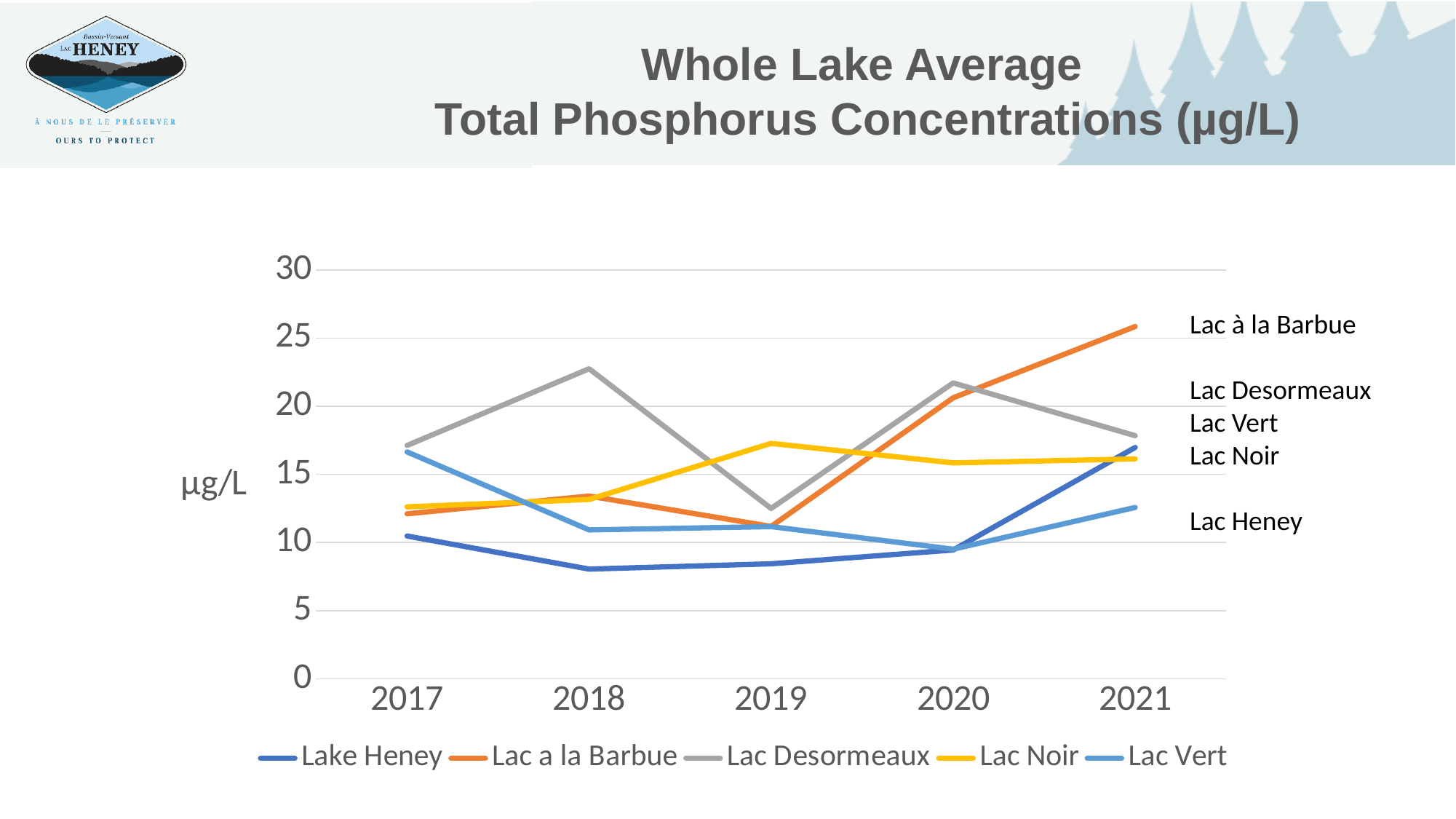
Which lake has the lowest total phosphorus concentration in 2018? Lake Heney What kind of chart is shown on the slide? line chart Is the value for Lac a la Barbue in 2021 greater or less than 25? greater How many years are shown on the x axis? 5 Which lake has the highest total phosphorus concentration in 2018? Lac Desormeaux Is the value for Lac Desormeaux in 2018 greater or less than 20? greater Does the value for Lac a la Barbue rise or fall from 2019 to 2021? rise How many series does the legend list? 5 Which lake has the highest total phosphorus concentration in 2021? Lac a la Barbue What is the label on the vertical axis? µg/L Is the value for Lake Heney in 2018 greater or less than 10? less In 2019, which is larger: the value for Lac Noir or the value for Lac Desormeaux? Lac Noir